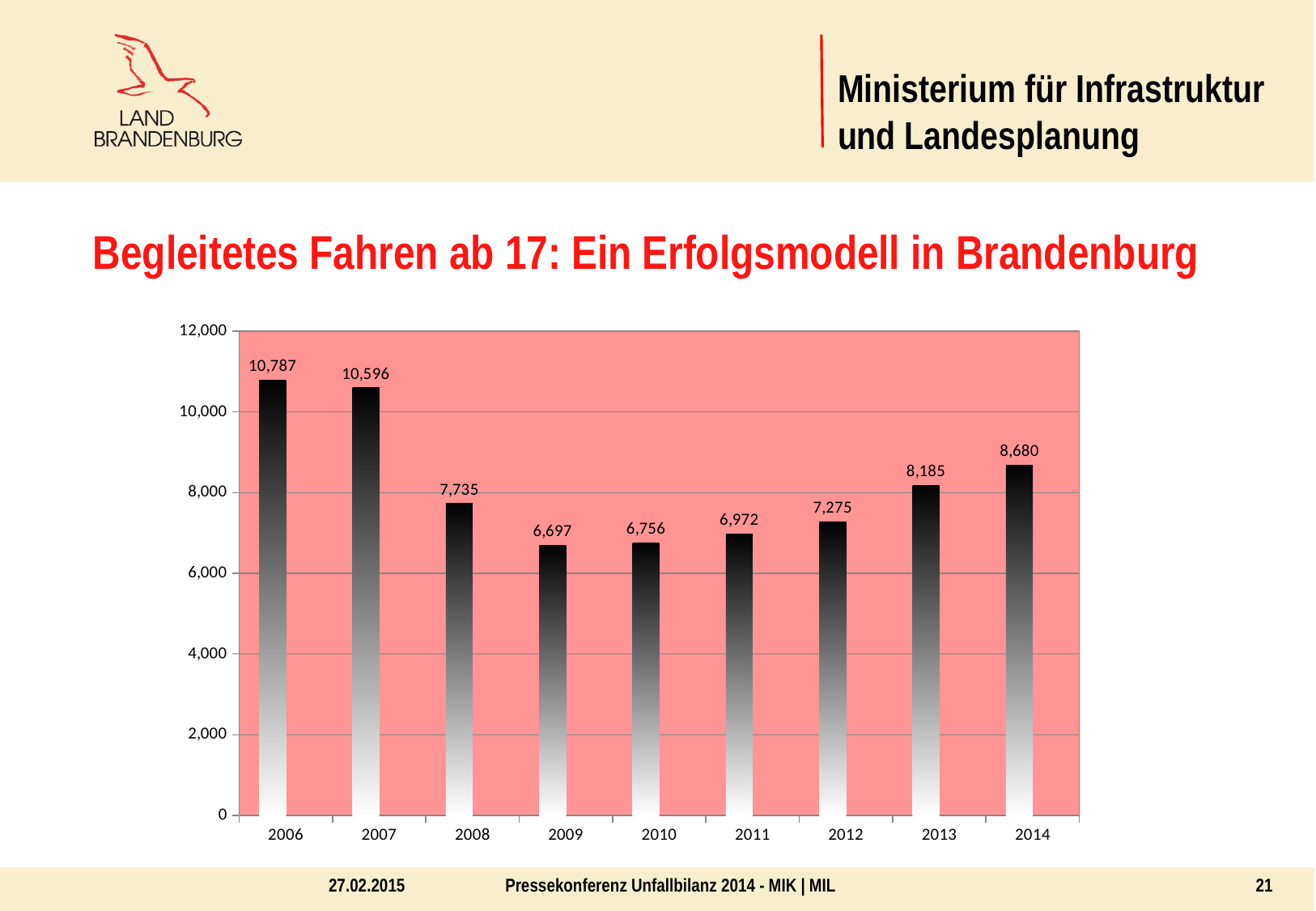
What is the difference between the values for 2014 and 2013? 495 Is the value for 2011 greater or less than 8,000? less Which year has the lowest value? 2009 Which is larger, the value for 2008 or the value for 2012? 2008 Which year has the highest value? 2006 What kind of chart is shown on the slide? bar chart Do the values rise or fall from 2009 to 2014? rise What is the value for 2014? 8,680 How many years are shown on the x axis? 9 What is the value for 2006? 10,787 What is the value for 2009? 6,697 What is the difference between the values for 2006 and 2007? 191